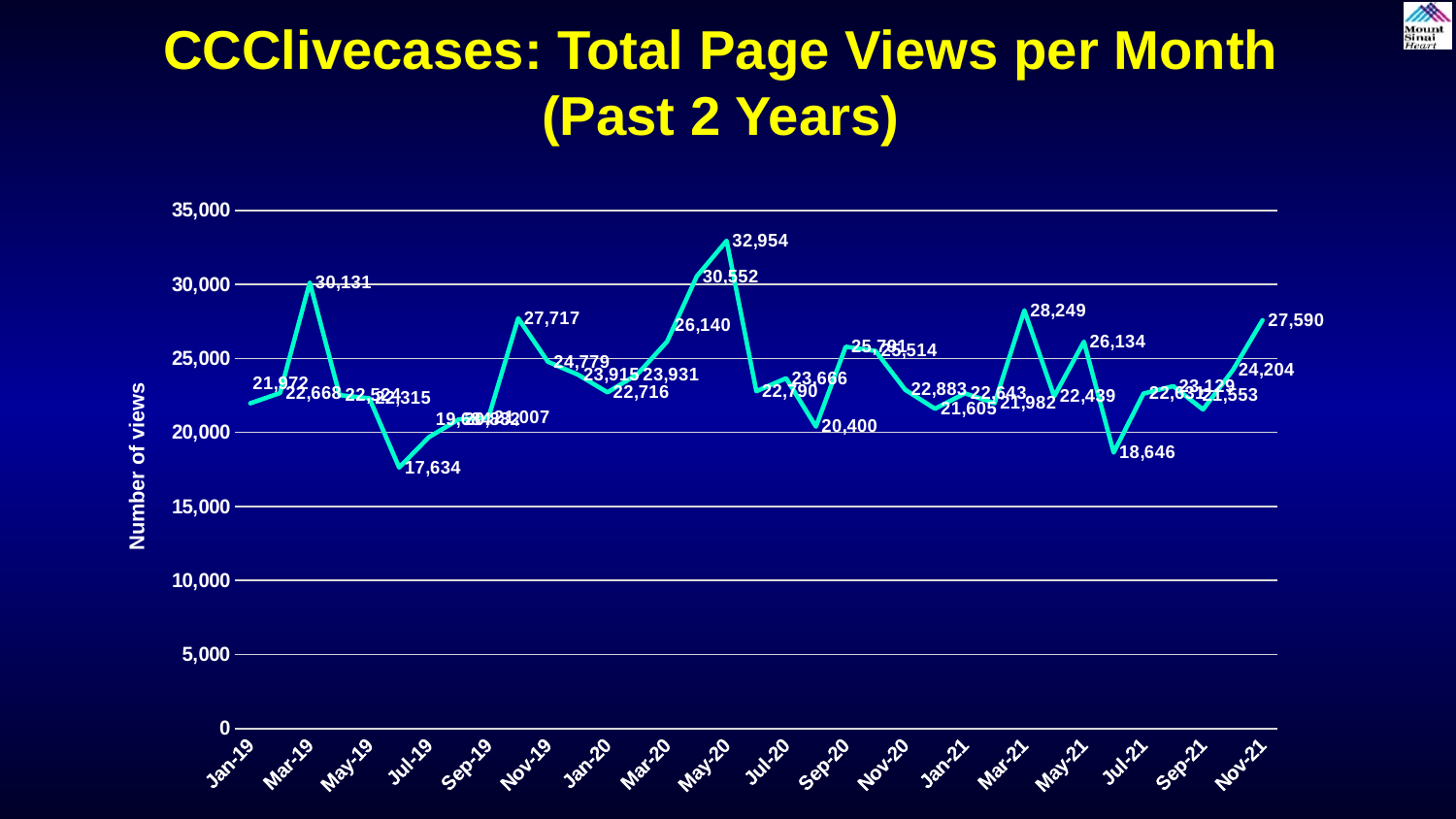
Is the value for Nov-21 greater or less than 25,000? greater What type of chart is shown on the slide? line chart In which month did page views reach their highest value? May-20 What is the lowest number of page views shown on the chart? 17,634 What is the number of page views for Nov-21? 27,590 How much higher is the value for Nov-21 (27,590) than the value for Jan-19 (21,972)? 5,618 What is the title of the y axis? Number of views What is the highest number of page views shown on the chart? 32,954 What is the number of page views for Jan-19? 21,972 Which is larger, the value for May-20 or the value for Jan-19? May-20 How many month labels are shown on the x axis? 18 What is the difference between the highest value (32,954) and the lowest value (17,634) on the chart? 15,320